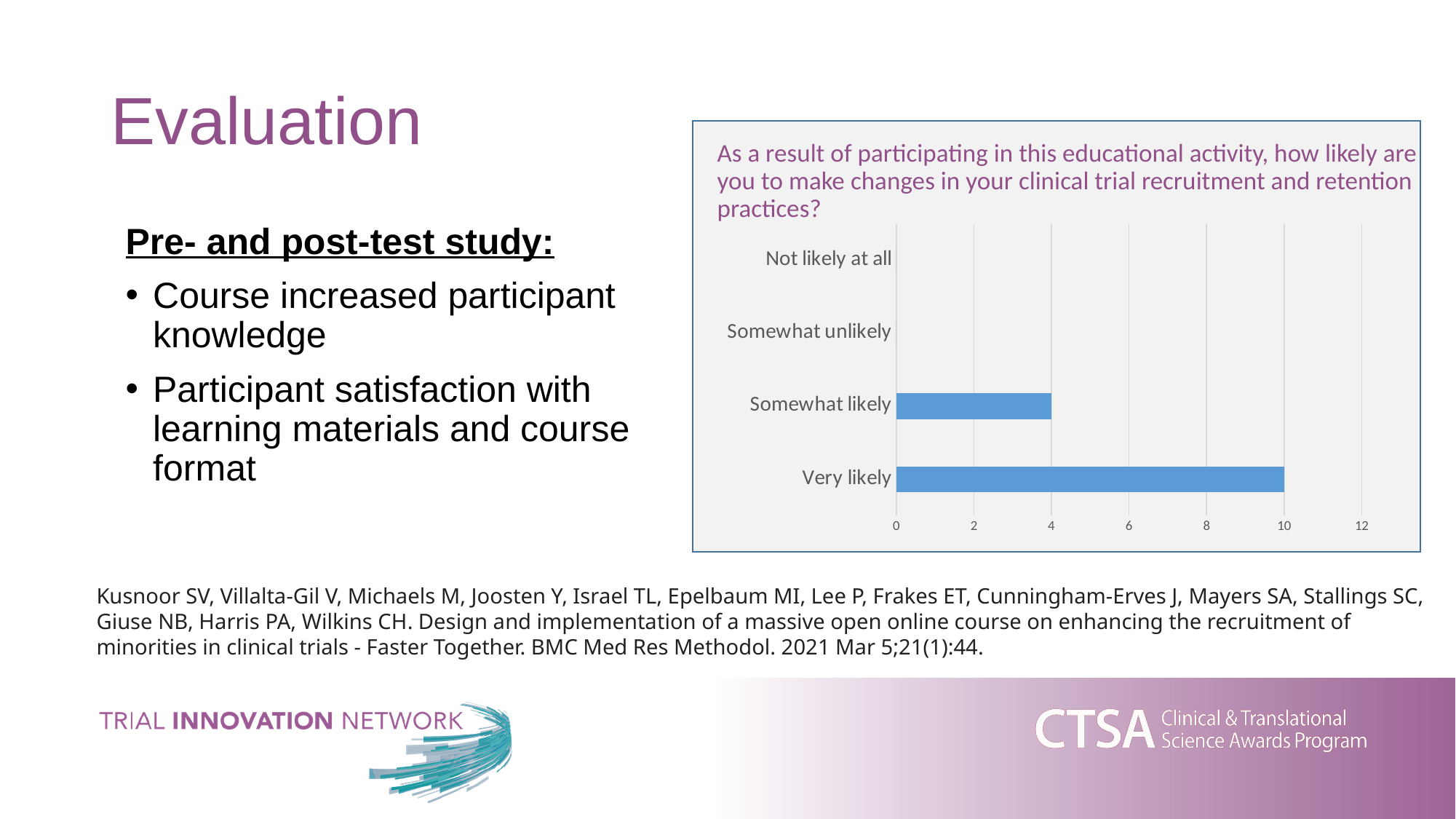
How many response categories are shown on the chart? 4 What kind of chart is shown on the slide? bar chart Which is larger, the value for "Very likely" or the value for "Somewhat likely"? Very likely What is the highest value shown on the chart's horizontal axis? 12 What is the difference between the values for "Very likely" and "Somewhat likely"? 6 Which response categories show no bar at all? Not likely at all and Somewhat unlikely Is the value for "Very likely" greater or less than 8? greater What is the value for "Somewhat likely"? 4 What question does the chart title ask? As a result of participating in this educational activity, how likely are you to make changes in your clinical trial recruitment and retention practices? Which response category has the highest value? Very likely What is the value for "Very likely"? 10 Is the value for "Somewhat likely" greater or less than 6? less